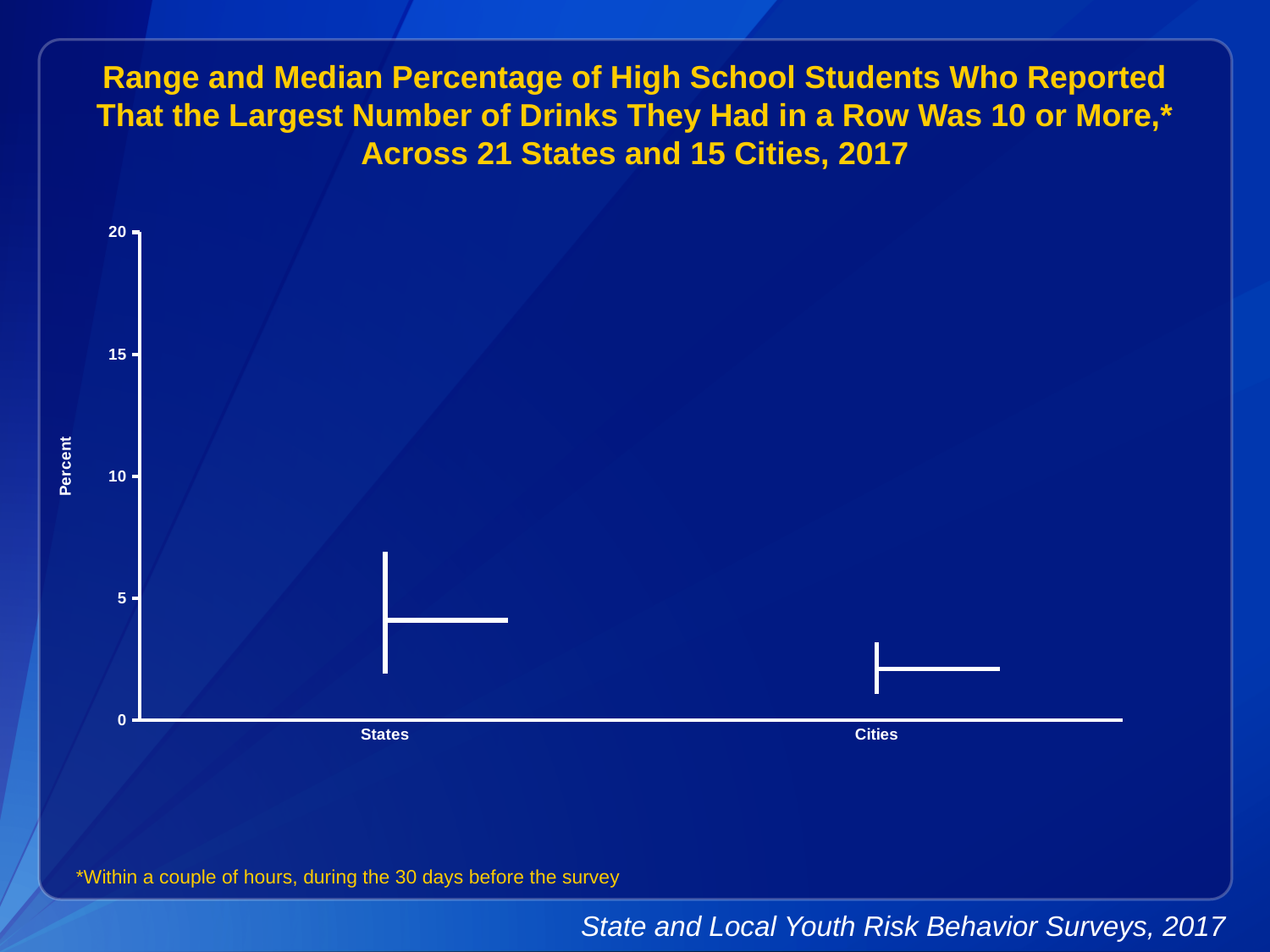
How many categories are shown on the x axis of the chart? 2 Which category has the higher top of its range, States or Cities? States Is the median value for States greater or less than 5? less Which category has the higher median value, States or Cities? States Which category has the lower median value? Cities What is the highest value shown on the y axis? 20 Is the top of the range for States greater or less than 5? greater Is the median value for Cities greater or less than 5? less What are the two categories shown on the x axis? States and Cities What is the label of the y axis? Percent